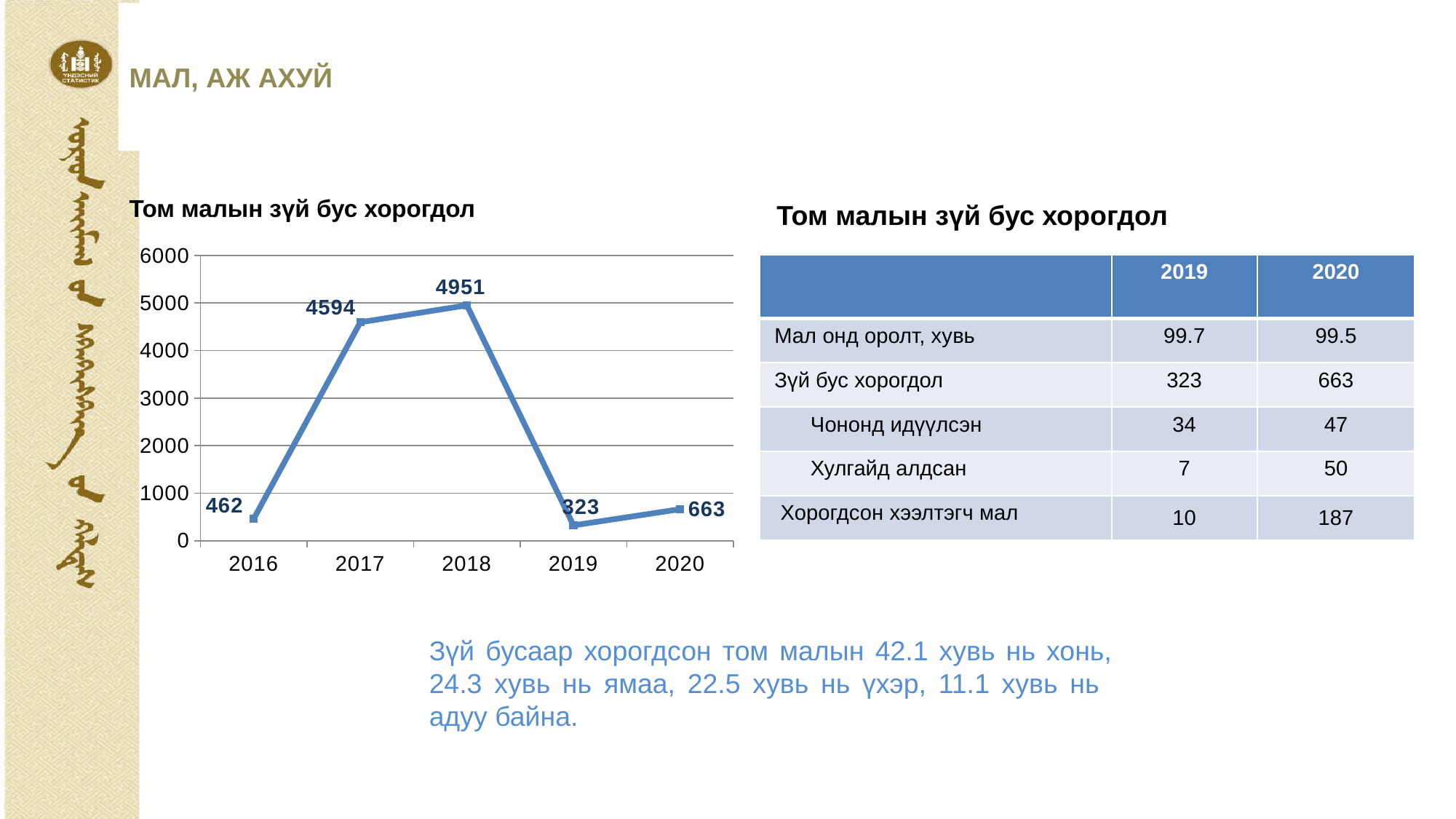
What is the difference between the values for 2020 and 2019 in the line chart? 340 Which year has the lowest value in the line chart? 2019 Which year has the highest value in the line chart? 2018 What is the value for 2016 in the line chart? 462 What is the title of the chart on the slide? Том малын зүй бус хорогдол Which is larger in the line chart, the value for 2016 or the value for 2020? 2020 What type of chart is shown on the slide? line chart What is the value for 2020 in the line chart? 663 What is the value for 2018 in the line chart? 4951 Is the value for 2017 in the line chart greater or less than 4000? greater How many years are plotted in the line chart? 5 What is the difference between the values for 2018 and 2017 in the line chart? 357